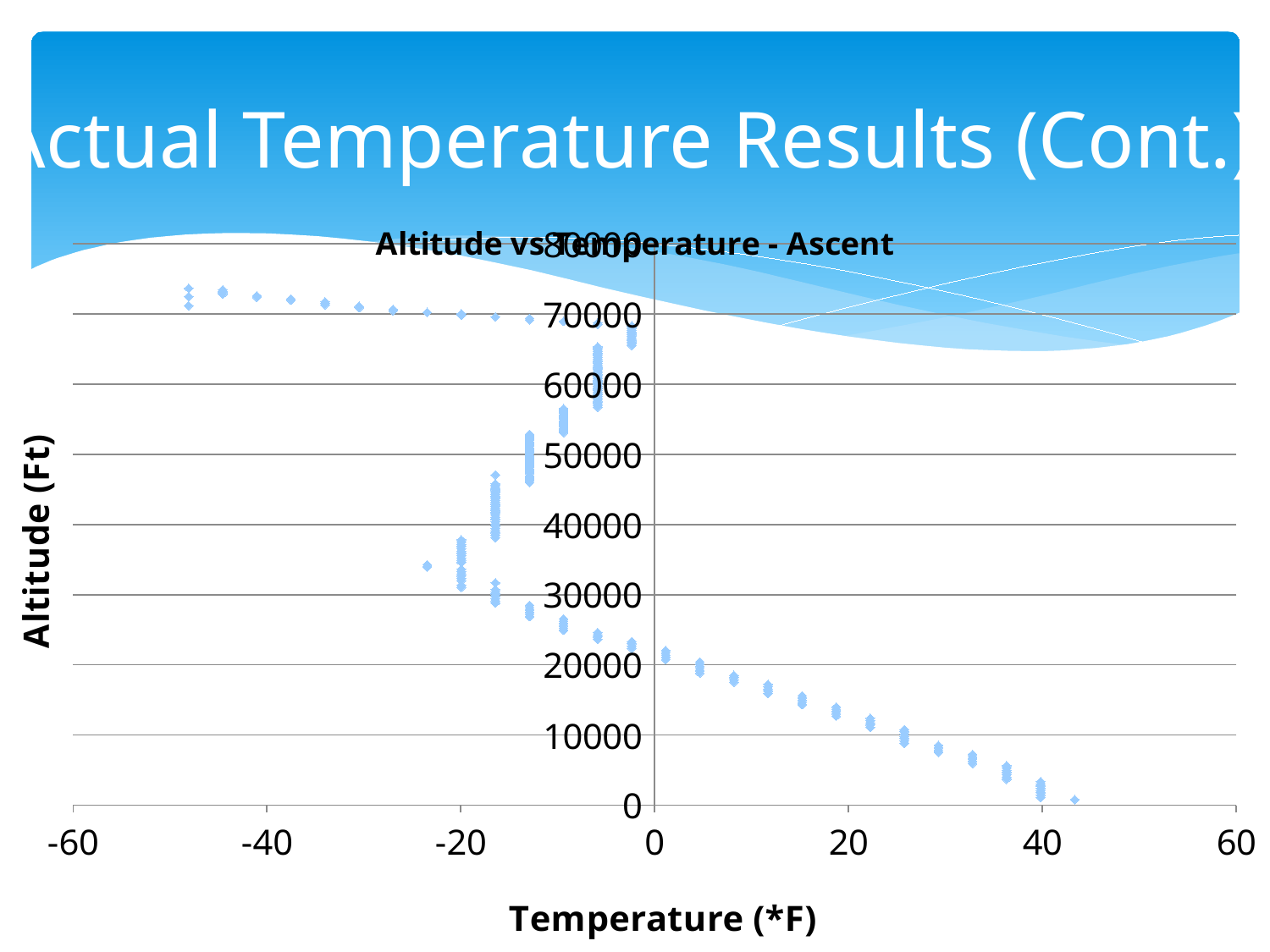
Is the altitude of the points plotted near a temperature of 20 greater or less than 20000? less What is the highest value shown on the horizontal axis? 60 Is the altitude of the points plotted near a temperature of 40 greater or less than 10000? less Is the altitude of the points plotted near a temperature of -20 greater or less than 20000? greater Which has the higher altitude: the points near a temperature of -45 or the points near a temperature of 30? the points near -45 What is the label of the horizontal axis? Temperature (*F) What kind of chart is shown on the slide? Scatter chart What is the title of the chart? Altitude vs Temperature - Ascent Moving from a temperature of 0 to 40 along the x axis, does the altitude of the points rise or fall? fall